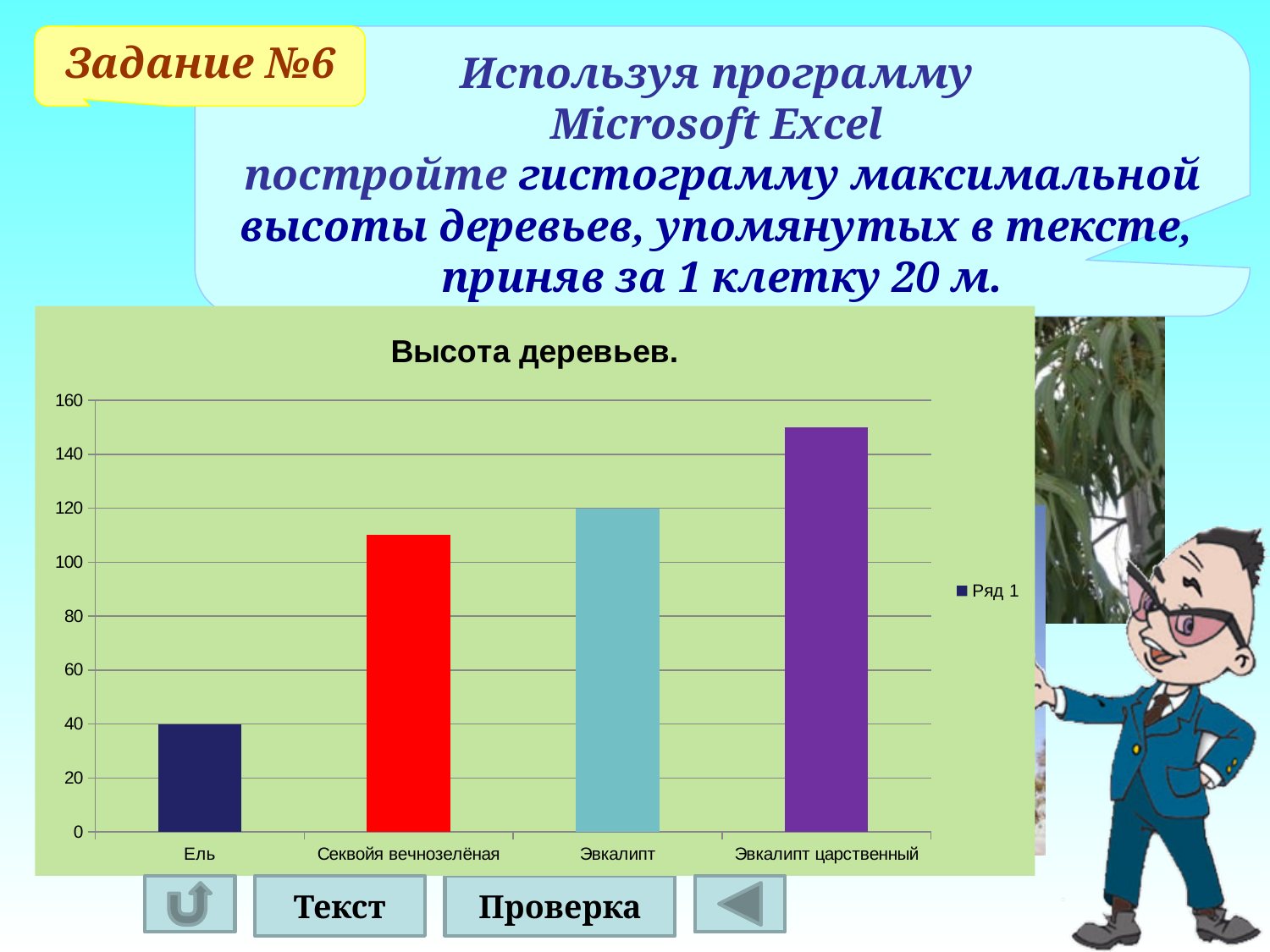
Is the value for Эвкалипт царственный greater or less than 160 in the chart "Высота деревьев."? less How many categories are shown in the chart "Высота деревьев."? 4 What is the difference between the values for Эвкалипт and Ель in the chart "Высота деревьев."? 80 What is the value for Эвкалипт in the chart "Высота деревьев."? 120 Which category has the highest value in the chart "Высота деревьев."? Эвкалипт царственный Is the value for Секвойя вечнозелёная greater or less than 100 in the chart "Высота деревьев."? greater What is the legend entry shown in the chart "Высота деревьев."? Ряд 1 What is the value for Ель in the chart "Высота деревьев."? 40 Which category has the lowest value in the chart "Высота деревьев."? Ель How many series does the legend of the chart "Высота деревьев." list? 1 Which is larger in the chart "Высота деревьев.": the value for Секвойя вечнозелёная or the value for Эвкалипт? Эвкалипт What kind of chart is "Высота деревьев."? bar chart